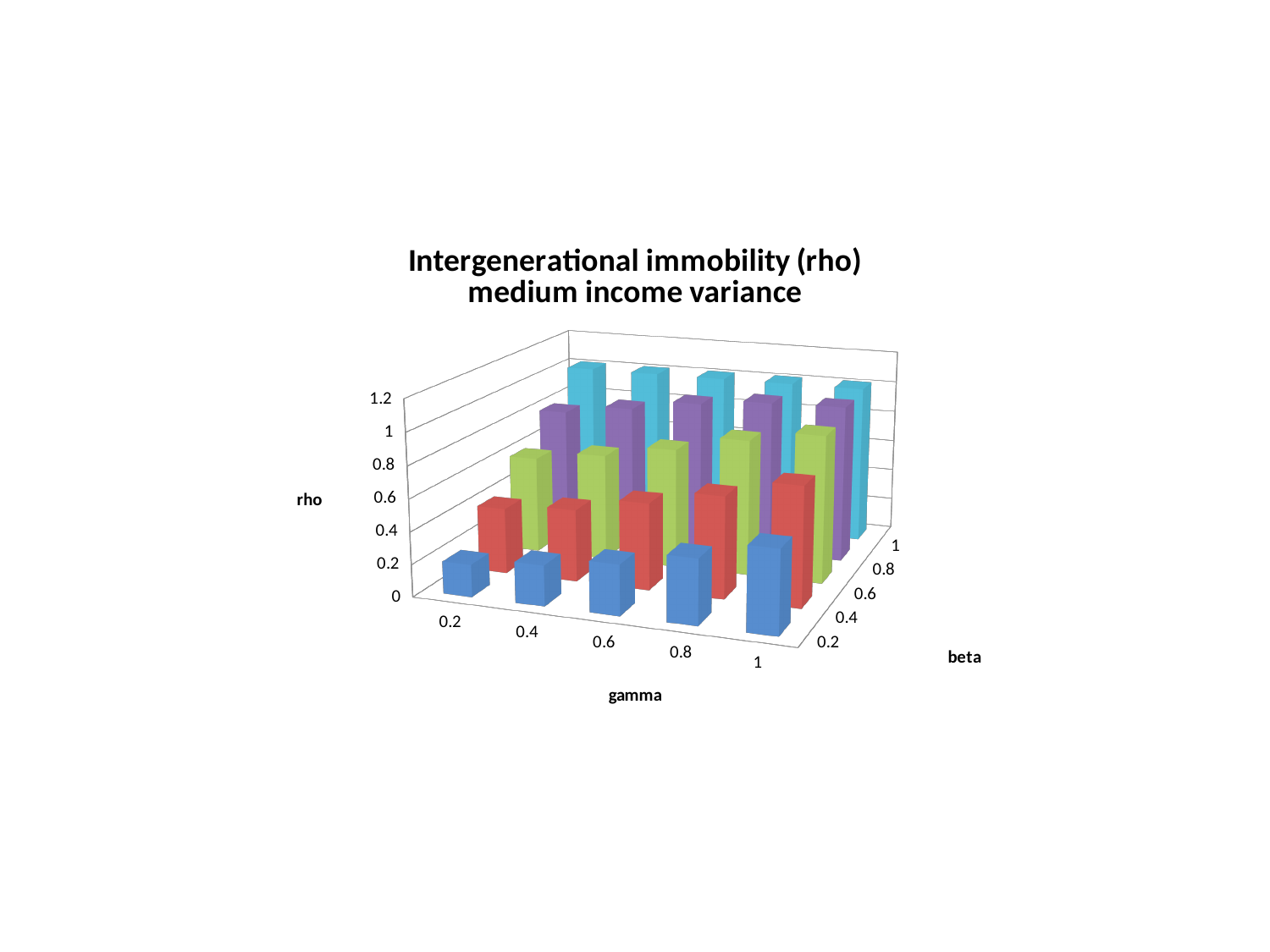
Is the rho value for gamma = 0.2 and beta = 0.8 greater or less than 0.4? greater What is the highest tick value shown on the rho axis? 1.2 How many gamma values are shown along the gamma axis? 5 What kind of chart is shown on the slide? 3D bar chart For beta = 0.2, do the rho values rise or fall as gamma increases from 0.2 to 1? rise Is the rho value for gamma = 0.2 and beta = 0.2 greater or less than 0.6? less How many bars are plotted in total on the chart? 25 What label is on the vertical axis of the chart? rho Is the rho value for gamma = 1 and beta = 1 greater or less than 0.6? greater For gamma = 0.2, do the rho values rise or fall as beta increases from 0.2 to 1? rise What is the title of the chart? Intergenerational immobility (rho) medium income variance How many beta values are shown along the beta axis? 5